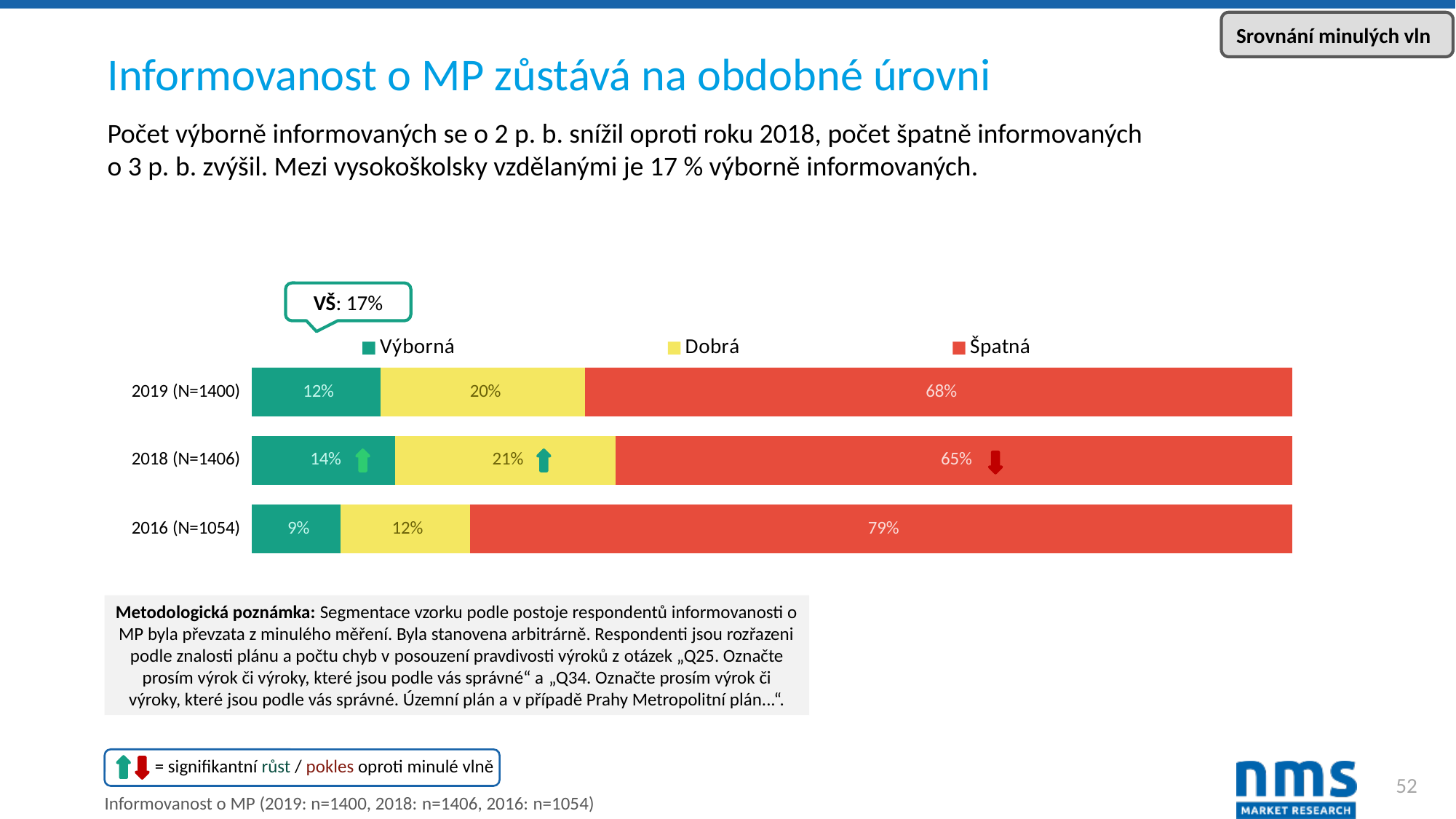
Which is larger: Dobrá in 2019 (N=1400) or Dobrá in 2018 (N=1406)? Dobrá in 2018 (N=1406) How many years (categories) are shown in the chart? 3 What is the total of the stacked bar for 2019 (N=1400)? 100% What is the difference between the Špatná values for 2016 (N=1054) and 2018 (N=1406)? 14% How many series does the legend list? 3 What is the value for Výborná in 2018 (N=1406)? 14% What kind of chart is shown on the slide? Stacked bar chart What value is shown in the callout labelled VŠ above the chart? 17% What is the value for Dobrá in 2016 (N=1054)? 12% Which year has the highest value for Špatná? 2016 (N=1054) Which year has the lowest value for Výborná? 2016 (N=1054) What is the value for Špatná in 2019 (N=1400)? 68%